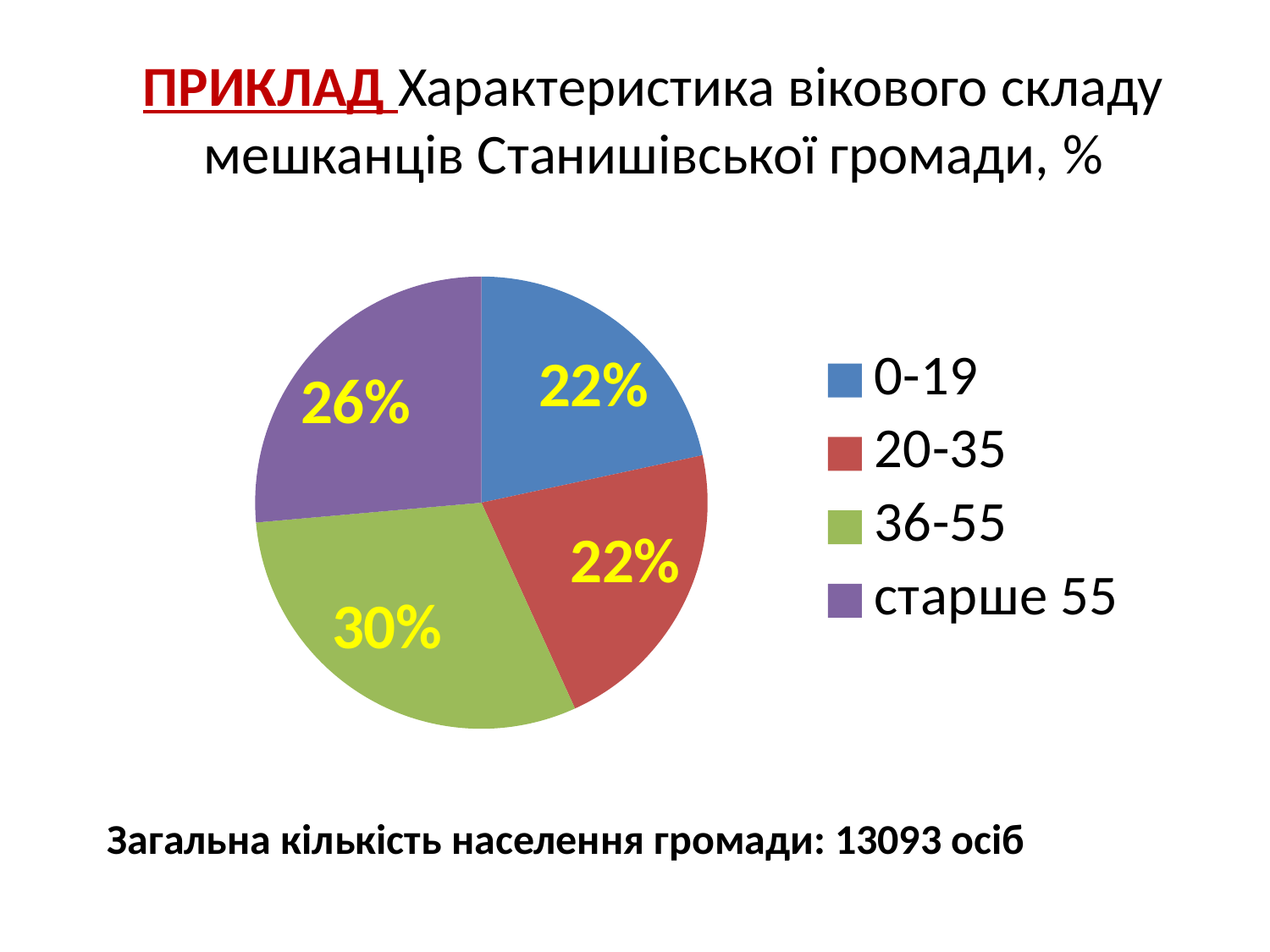
What is the combined share of the 0-19 and 20-35 age groups? 44% Which age group has the largest share of the pie? 36-55 What share of the pie does the 36-55 age group have? 30% Which age group is represented by the purple slice? старше 55 Which is larger, the share for 36-55 or the share for 0-19? 36-55 What colour is the slice for the 36-55 age group? green What is the value shown for the 0-19 age group? 22% What kind of chart is shown on the slide? pie chart What is the difference between the share of the 36-55 group and the share of the 'старше 55' group? 4% How many age groups are shown in the pie chart? 4 What share of the pie does the 'старше 55' age group have? 26% What is the value shown for the 20-35 age group? 22%